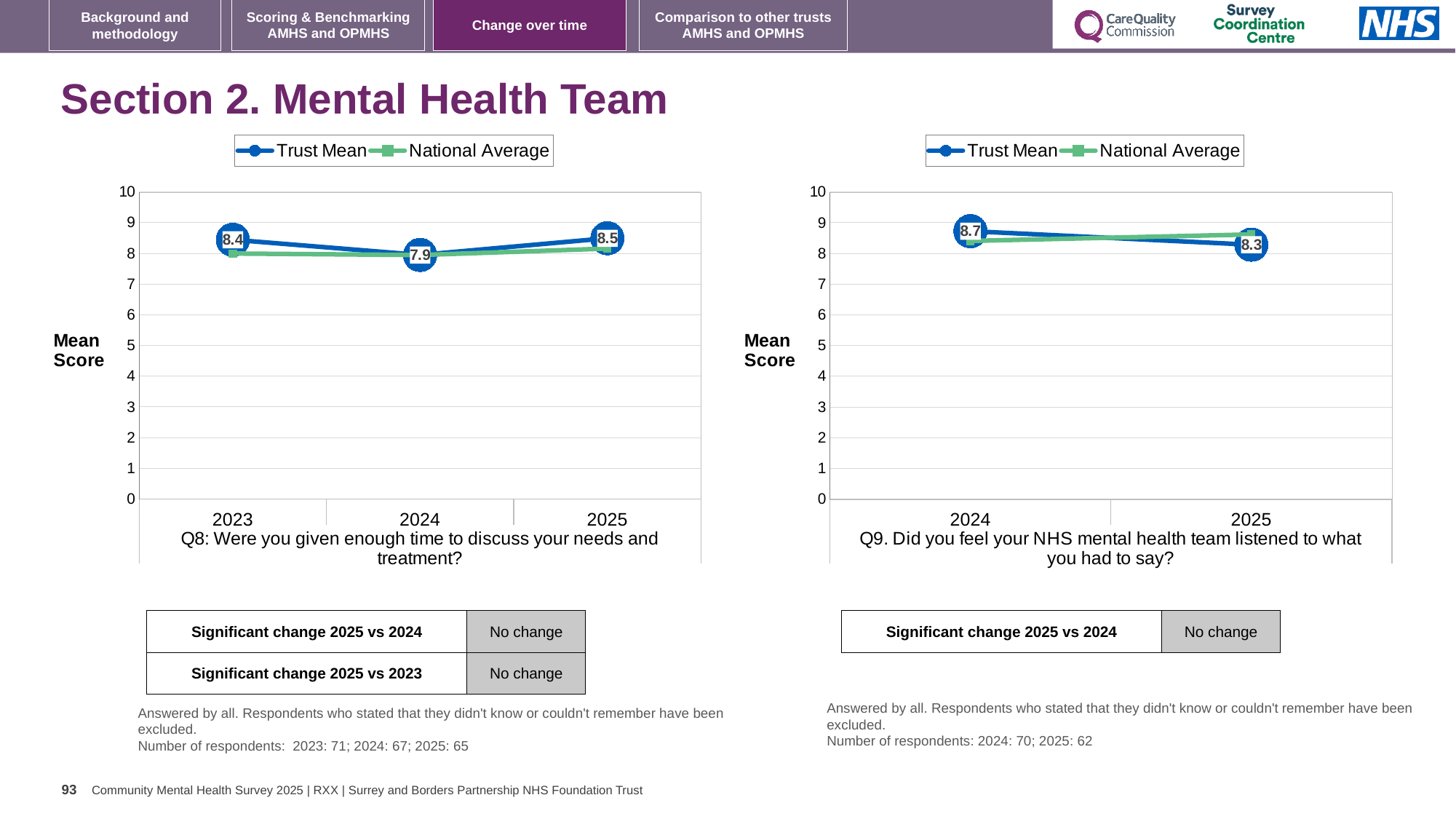
In the Q9 chart on the right, is the Trust Mean higher in 2024 or 2025? 2024 In the Q8 chart on the left, what is the Trust Mean for 2025? 8.5 In the Q9 chart on the right, what is the Trust Mean for 2024? 8.7 In the Q8 chart on the left, which year has the lowest Trust Mean? 2024 In the Q9 chart on the right, what is the Trust Mean for 2025? 8.3 How many series does the legend of the Q9 chart on the right list? 2 In the Q8 chart on the left, is the National Average for 2023 greater or less than 7? greater In the Q9 chart on the right, what is the difference between the Trust Mean for 2024 and for 2025? 0.4 In the Q8 chart on the left, which year has the highest Trust Mean? 2025 In the Q8 chart on the left, what is the Trust Mean for 2024? 7.9 How many years are shown on the x axis of the Q8 chart on the left? 3 In the Q8 chart on the left, what is the difference between the Trust Mean for 2025 and for 2024? 0.6